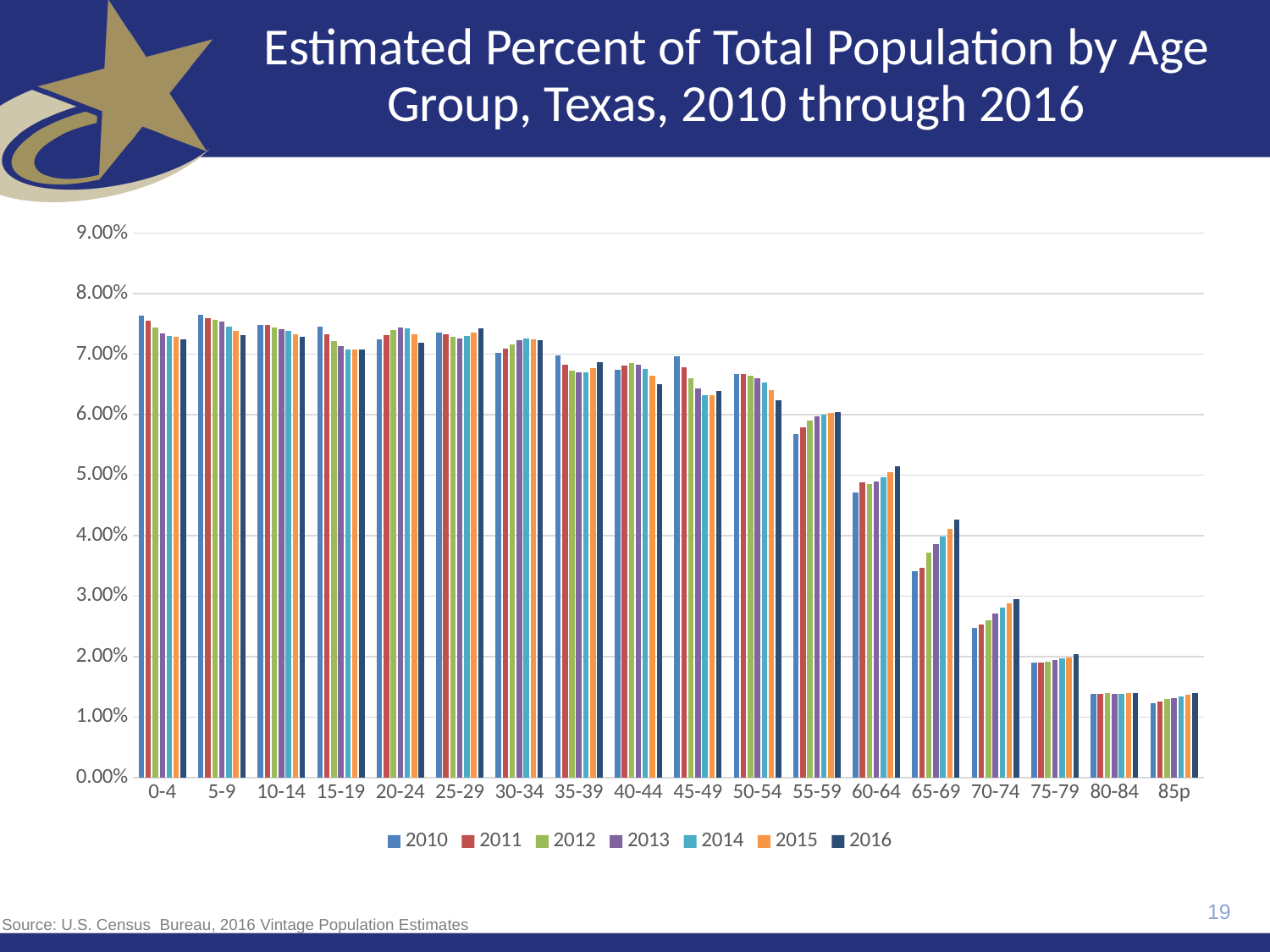
Is the value for the 85p age group in 2016 greater or less than 2.00%? less For the 0-4 age group, which year has the larger value, 2010 or 2016? 2010 How many age group categories are shown on the x axis? 18 What kind of chart is shown on the slide? bar chart Is the value for the 60-64 age group in 2010 greater or less than 5.00%? less Do the values for the 65-69 age group rise or fall from 2010 to 2016? rise What is the title of the chart? Estimated Percent of Total Population by Age Group, Texas, 2010 through 2016 Is the value for the 65-69 age group in 2016 greater or less than 4.00%? greater How many series does the legend list? 7 For the 65-69 age group, which year has the larger value, 2010 or 2016? 2016